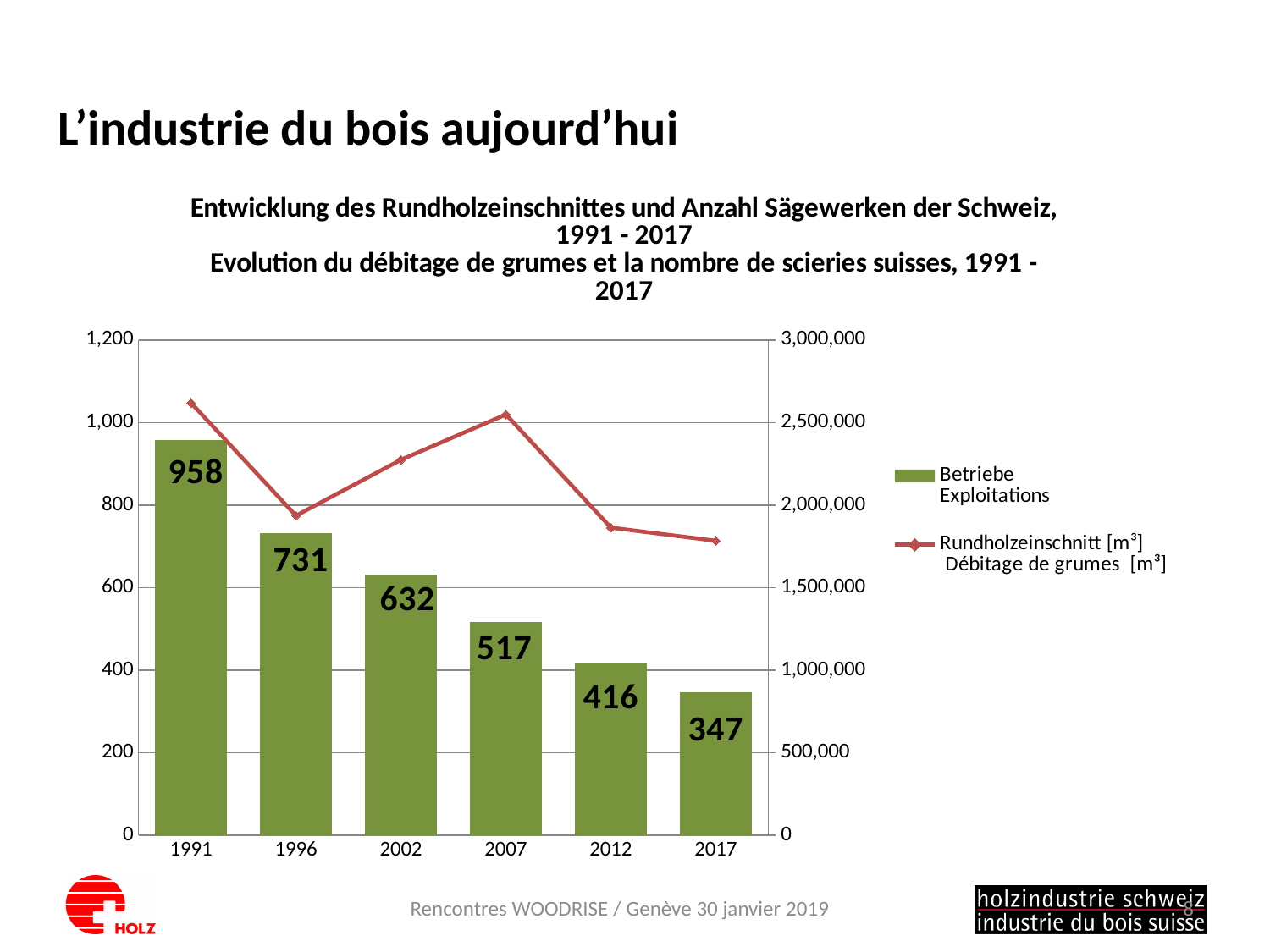
Is the Rundholzeinschnitt value for 1991 greater or less than 2,500,000 m³? greater What is the value of the Betriebe / Exploitations bar for 2007? 517 Which year has the highest Rundholzeinschnitt / Débitage de grumes value on the line? 1991 Which year has the lowest number of Betriebe / Exploitations? 2017 How many years are shown on the x axis? 6 Is the Rundholzeinschnitt value for 2017 greater or less than 2,000,000 m³? less How many series does the legend list? 2 What is the difference between the Betriebe / Exploitations values for 1996 and 2002? 99 What is the value of the Betriebe / Exploitations bar for 2017? 347 How many Betriebe / Exploitations were there in 1991? 958 Which year has the highest number of Betriebe / Exploitations? 1991 By how much did the number of Betriebe / Exploitations fall between 1991 and 2017? 611